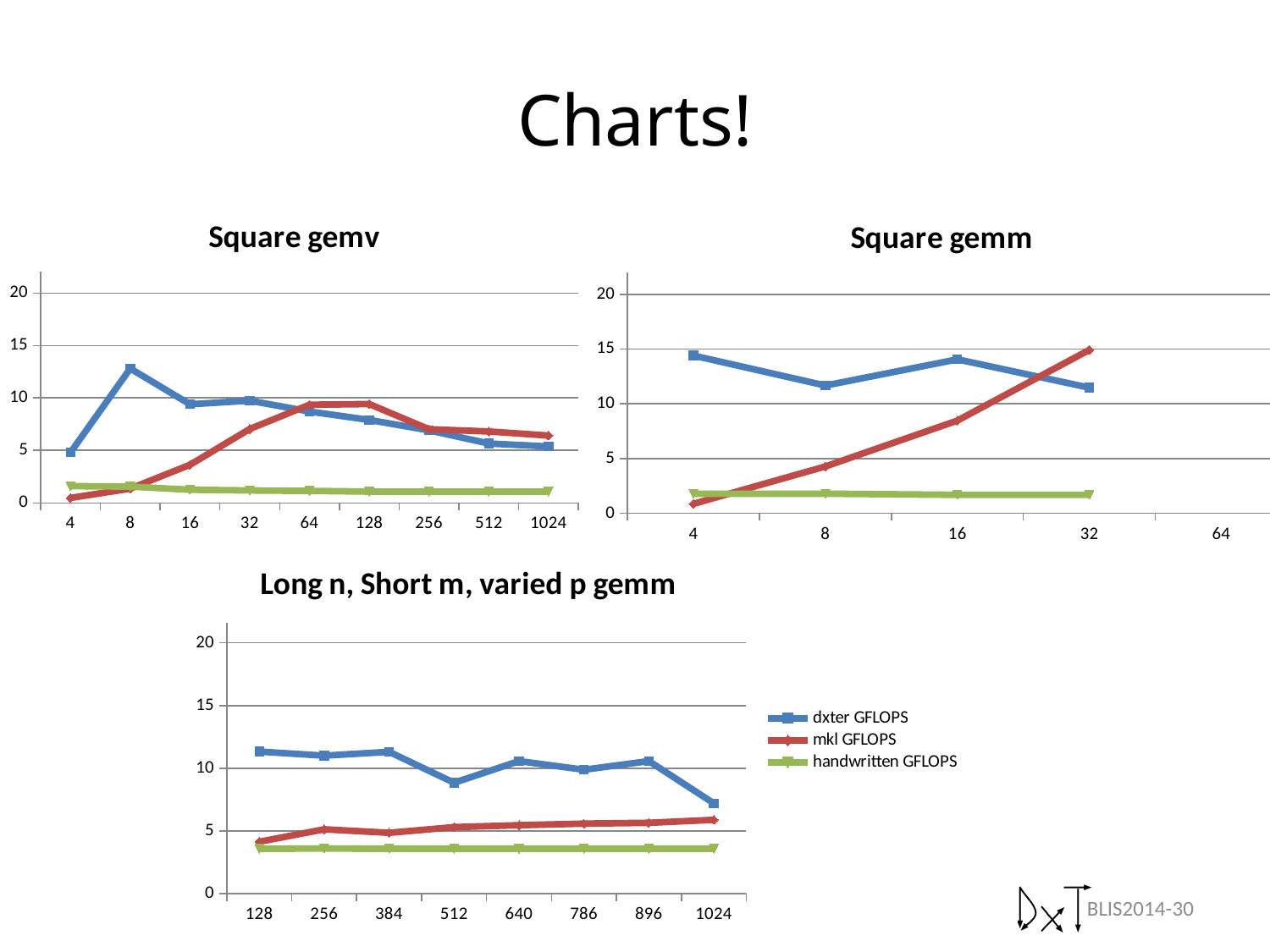
How many series does the legend list? 3 In the "Square gemm" chart, does mkl GFLOPS rise or fall as the x-axis value increases? rise In the "Square gemv" chart, at which x-axis value does dxter GFLOPS reach its highest point? 8 In the "Square gemm" chart, which is larger at 32: dxter GFLOPS or mkl GFLOPS? mkl GFLOPS In the "Square gemv" chart, which is larger at 16: dxter GFLOPS or mkl GFLOPS? dxter GFLOPS In the "Long n, Short m, varied p gemm" chart, how many x-axis categories are plotted? 8 What kind of chart is the "Square gemv" chart? line chart In the "Square gemv" chart, is the dxter GFLOPS value at 8 greater or less than 10? greater In the "Long n, Short m, varied p gemm" chart, is the dxter GFLOPS value at 512 greater or less than 10? less In the "Square gemm" chart, is the dxter GFLOPS value at 4 greater or less than 10? greater In the "Square gemv" chart, how many x-axis categories are plotted? 9 In the "Long n, Short m, varied p gemm" chart, at which x-axis value is dxter GFLOPS lowest? 1024